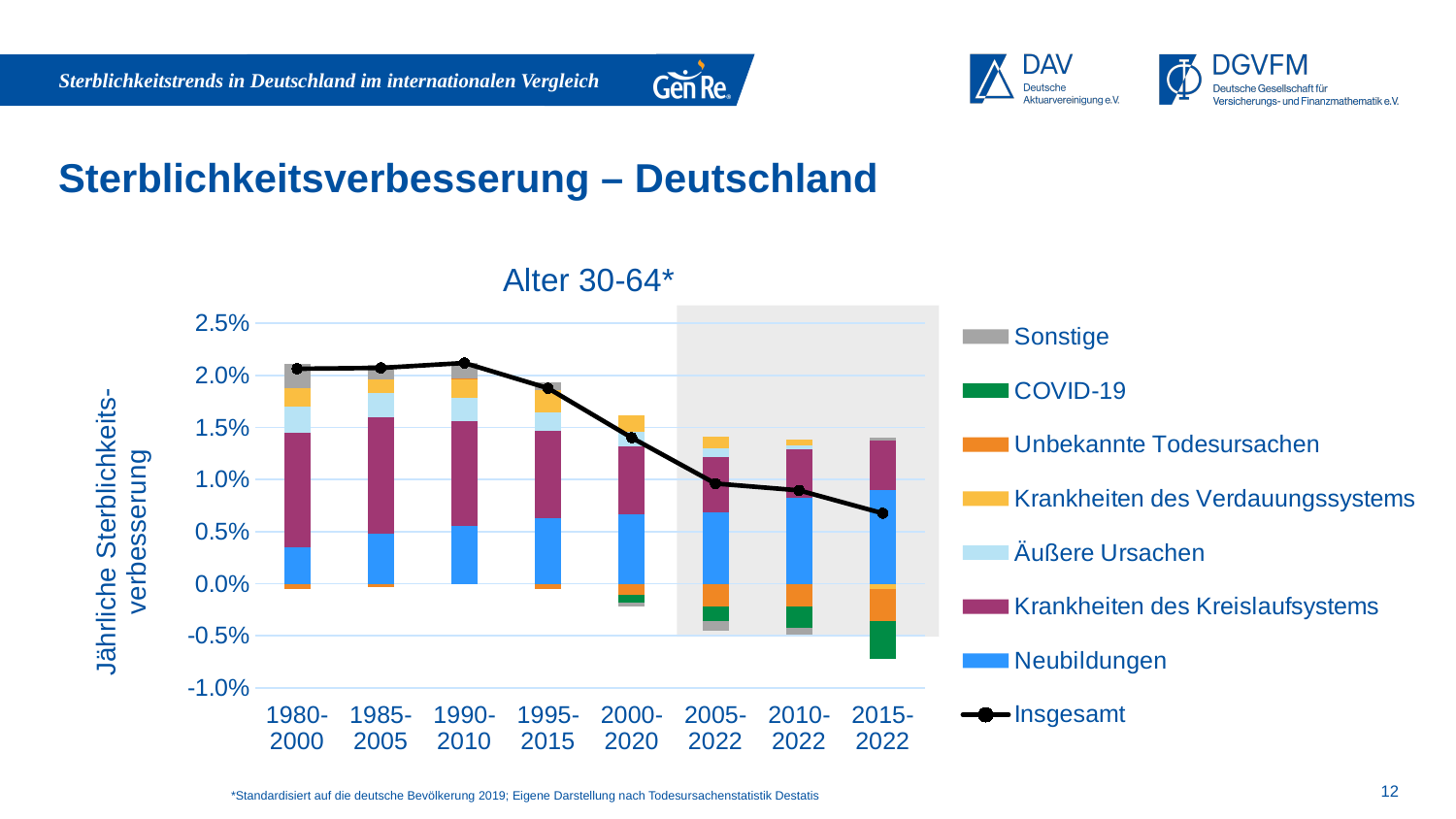
Is the Insgesamt value for 1995-2015 greater or less than 1.5%? greater What is the title of the chart? Alter 30-64* How many time periods are shown on the x axis of the chart? 8 Is the Insgesamt value for 2000-2020 greater or less than 1.0%? greater Is the Insgesamt value for 2015-2022 greater or less than 1.0%? less Which series is shown as a black line with markers in the chart? Insgesamt Does the Insgesamt line generally rise or fall from 1980-2000 to 2015-2022? Fall How many series does the chart legend list? 8 Which legend entry is shown in green? COVID-19 What kind of chart is shown on the slide? Stacked bar chart with a line Which period has the lowest value for the Insgesamt line? 2015-2022 Which is larger, the Insgesamt value for 1995-2015 or for 2005-2022? 1995-2015